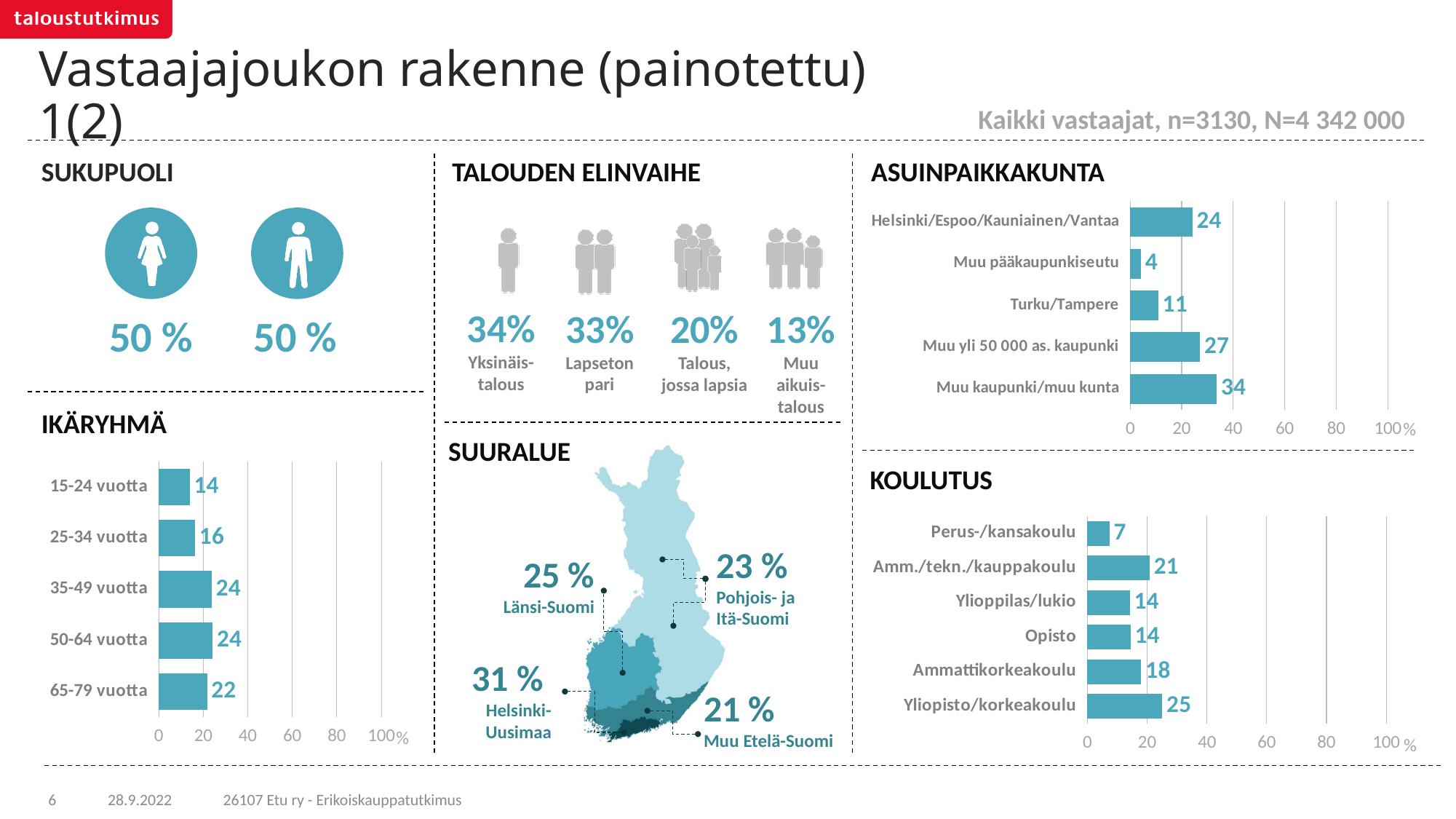
In the IKÄRYHMÄ chart, what is the difference between the values for 25-34 vuotta and 15-24 vuotta? 2 What kind of chart is the KOULUTUS chart? bar chart In the IKÄRYHMÄ chart, what is the value for 65-79 vuotta? 22 In the ASUINPAIKKAKUNTA chart, which category has the lowest value? Muu pääkaupunkiseutu In the ASUINPAIKKAKUNTA chart, which is larger: Helsinki/Espoo/Kauniainen/Vantaa or Muu yli 50 000 as. kaupunki? Muu yli 50 000 as. kaupunki In the ASUINPAIKKAKUNTA chart, what is the value for Turku/Tampere? 11 In the ASUINPAIKKAKUNTA chart, which category has the highest value? Muu kaupunki/muu kunta How many categories does the KOULUTUS chart show? 6 In the IKÄRYHMÄ chart, which age group has the lowest value? 15-24 vuotta In the KOULUTUS chart, which category has the highest value? Yliopisto/korkeakoulu How many categories does the IKÄRYHMÄ chart show? 5 In the KOULUTUS chart, what is the value for Ammattikorkeakoulu? 18